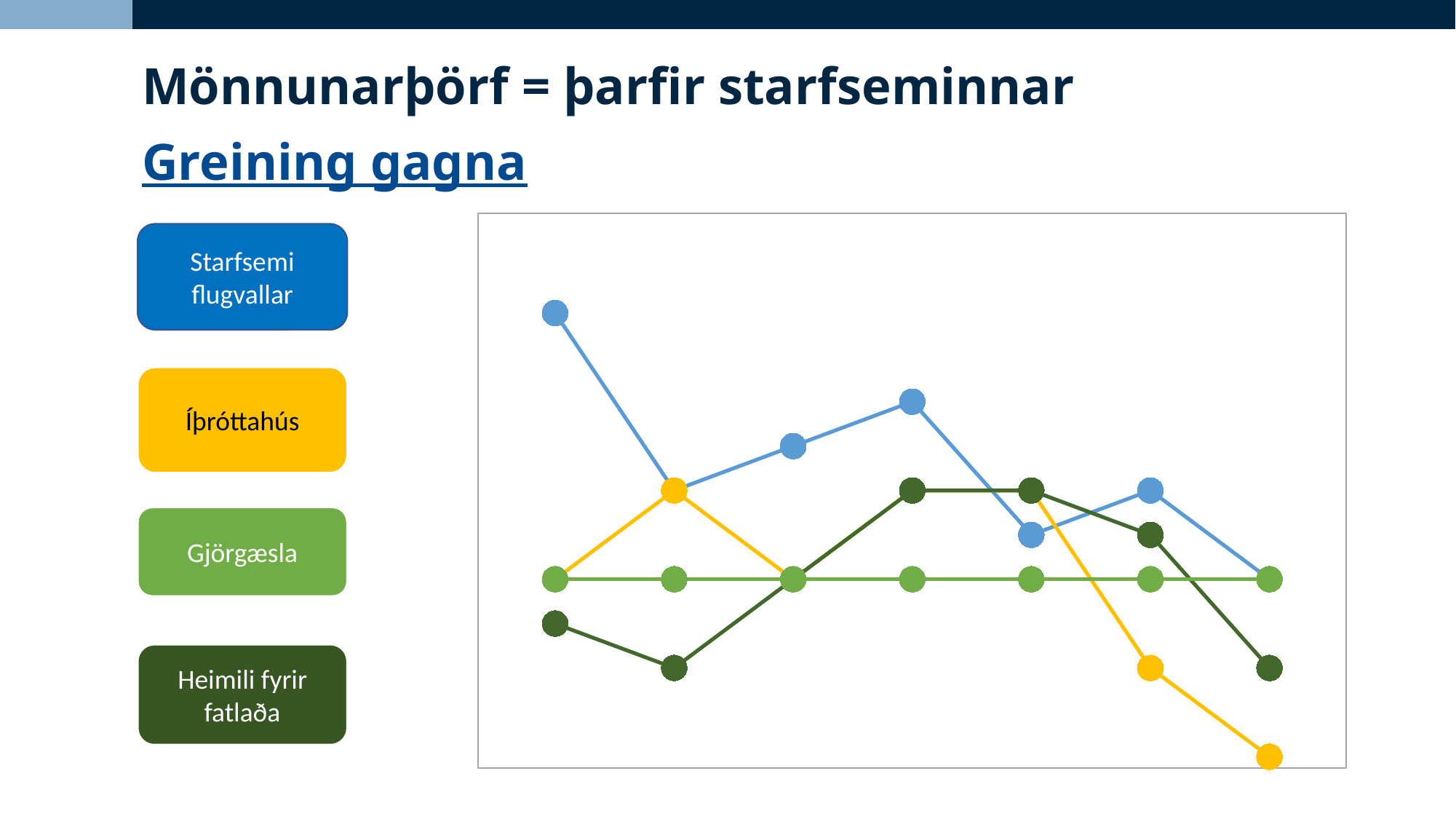
At the first point, which is higher: Starfsemi flugvallar or Heimili fyrir fatlaða? Starfsemi flugvallar How many data points does each line on the chart have? 7 Which series has the lowest point on the chart? Íþróttahús Which series reaches the highest point on the chart? Starfsemi flugvallar Does the Starfsemi flugvallar line end higher or lower than it starts? lower Which series is drawn in dark green? Heimili fyrir fatlaða Does the Gjörgæsla line rise, fall or stay flat across the chart? stays flat At the last point, which is higher: Gjörgæsla or Íþróttahús? Gjörgæsla Does the Íþróttahús line end higher or lower than it starts? lower How many series (lines) are plotted on the chart? 4 Which colour represents Íþróttahús on the chart? yellow What kind of chart is shown on the slide? line chart